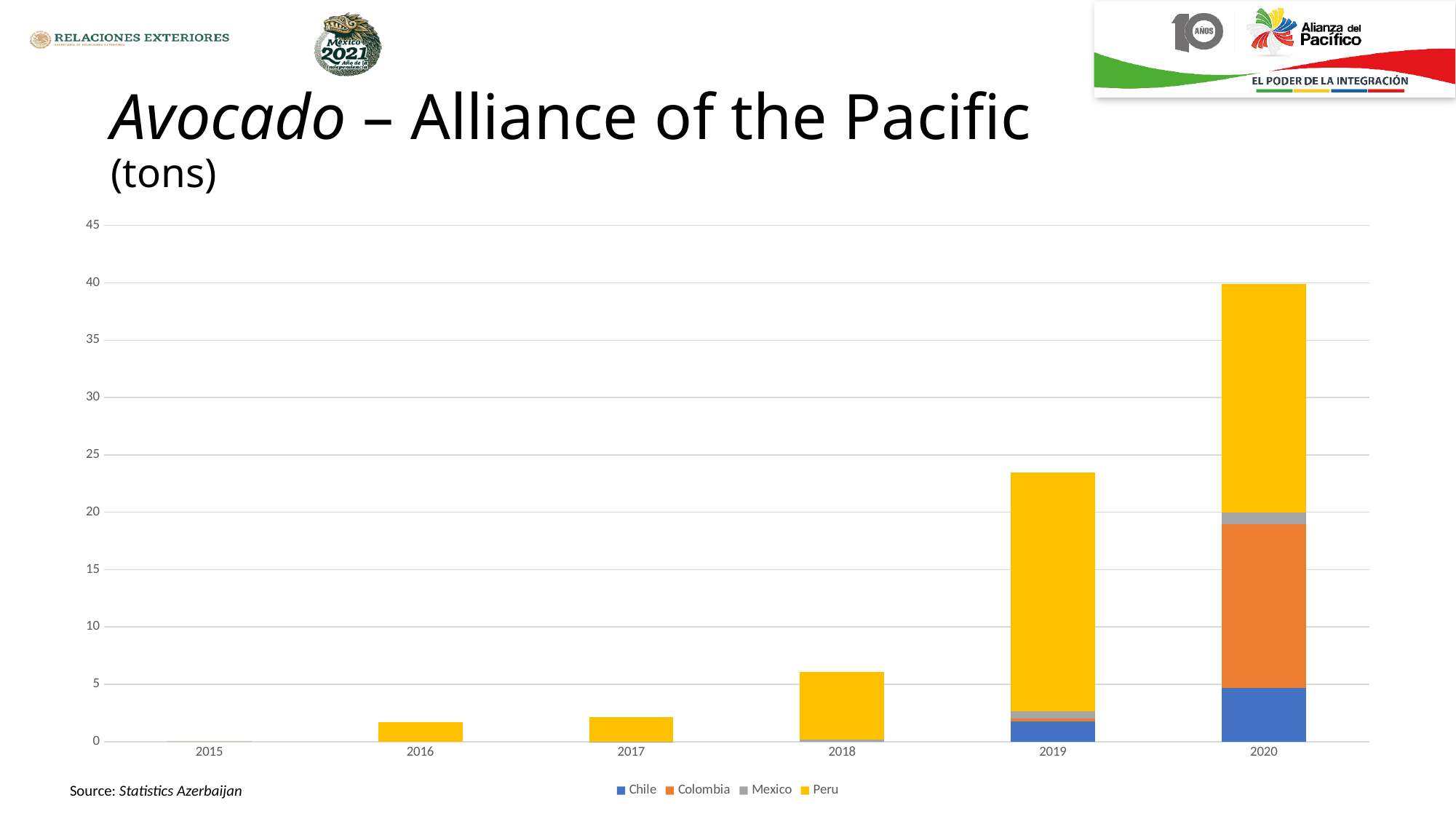
Is the total value for 2020 greater or less than 35? greater How many series does the chart legend list? 4 Which colour represents Peru in the chart legend? Yellow Do the total values rise or fall from 2015 to 2020? Rise Is the total value for 2019 greater or less than 20? greater Is the total value for 2016 greater or less than 5? less Which year has the tallest stacked bar? 2020 In 2020, which series has the larger segment, Chile or Colombia? Colombia Which year has the smallest stacked bar? 2015 What kind of chart is shown on the slide? Stacked bar chart Which year has the larger total, 2018 or 2019? 2019 How many years are shown along the x axis of the chart? 6